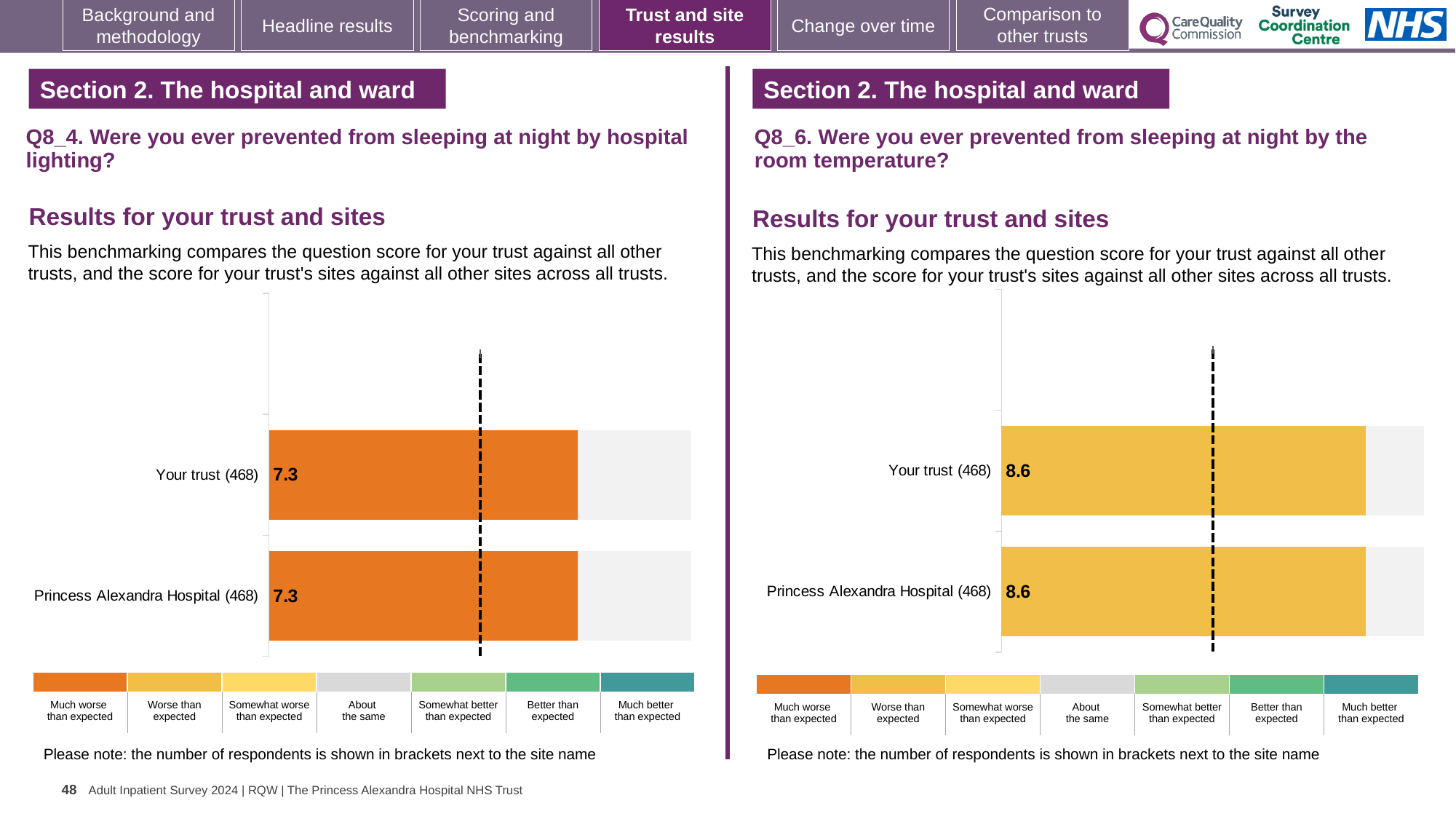
On the Q8_4 chart (hospital lighting), what is the difference between the Your trust score and the Princess Alexandra Hospital score? 0.0 On the Q8_6 chart (room temperature), which benchmark category does the colour of the bars correspond to in the legend? Worse than expected On the Q8_4 chart (hospital lighting), what is the score for Princess Alexandra Hospital? 7.3 How many bars are plotted on the Q8_4 chart (hospital lighting)? 2 How many bars are plotted on the Q8_6 chart (room temperature)? 2 What kind of chart is used on the Q8_4 chart (hospital lighting)? Bar chart How many respondents are shown in brackets for Your trust on the Q8_6 chart (room temperature)? 468 On the Q8_4 chart (hospital lighting), which benchmark category does the colour of the bars correspond to in the legend? Much worse than expected On the Q8_6 chart (room temperature), what is the difference between the Your trust score and the Princess Alexandra Hospital score? 0.0 On the Q8_6 chart (room temperature), what is the score for Princess Alexandra Hospital? 8.6 On the Q8_4 chart (hospital lighting), what is the score for Your trust? 7.3 On the Q8_6 chart (room temperature), what is the score for Your trust? 8.6